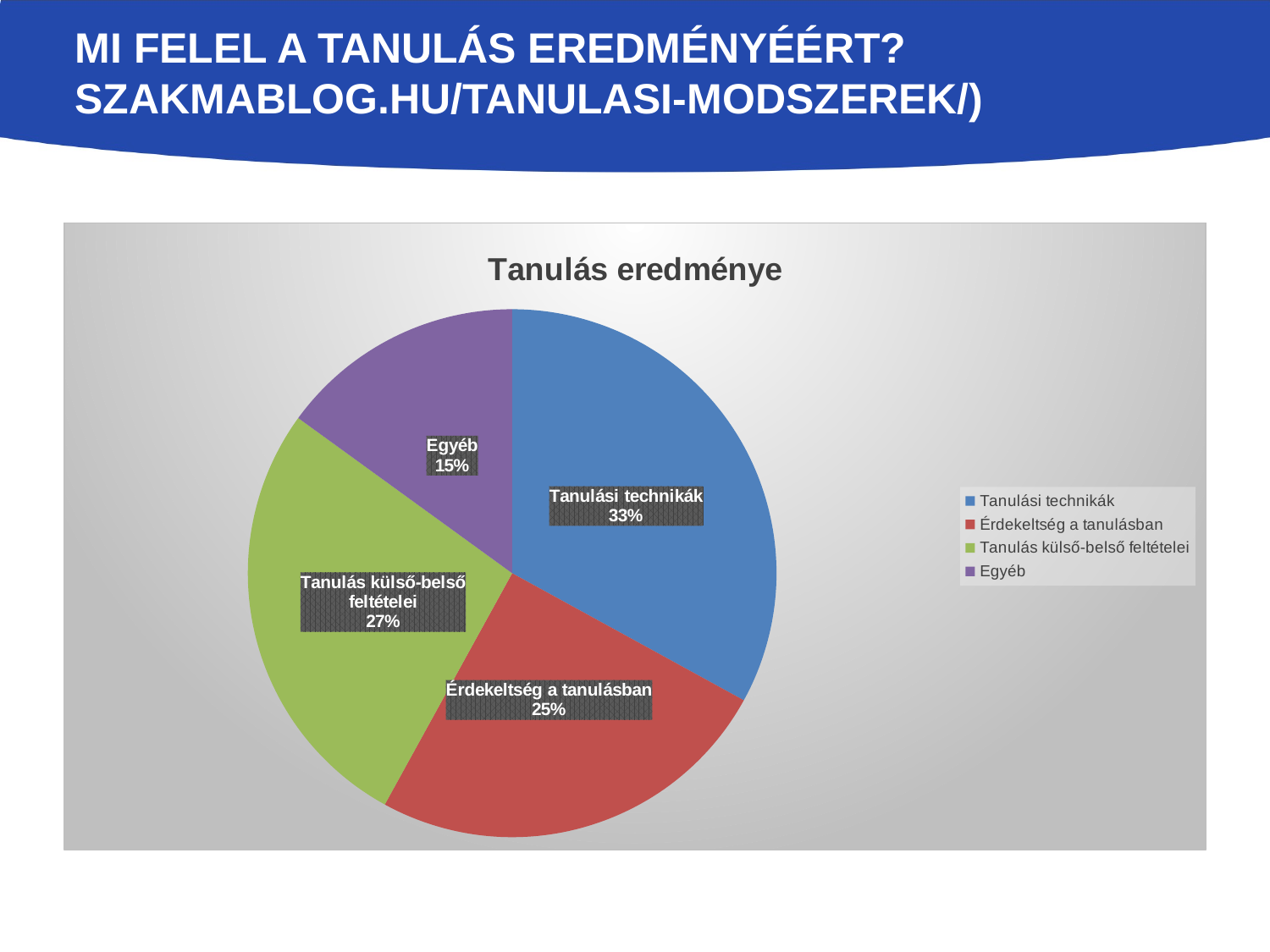
Which category has the smallest share of the pie? Egyéb What share of the pie does Egyéb have? 15% What colour is the Egyéb slice? purple What share of the pie does Tanulási technikák have? 33% What share of the pie does Érdekeltség a tanulásban have? 25% How many slices does the pie chart have? 4 What is the difference in percentage points between Tanulási technikák and Egyéb? 18 What type of chart is shown on the slide? pie chart Which is larger, the share for Tanulás külső-belső feltételei or the share for Érdekeltség a tanulásban? Tanulás külső-belső feltételei Which category has the largest share of the pie? Tanulási technikák What is the title of the chart? Tanulás eredménye